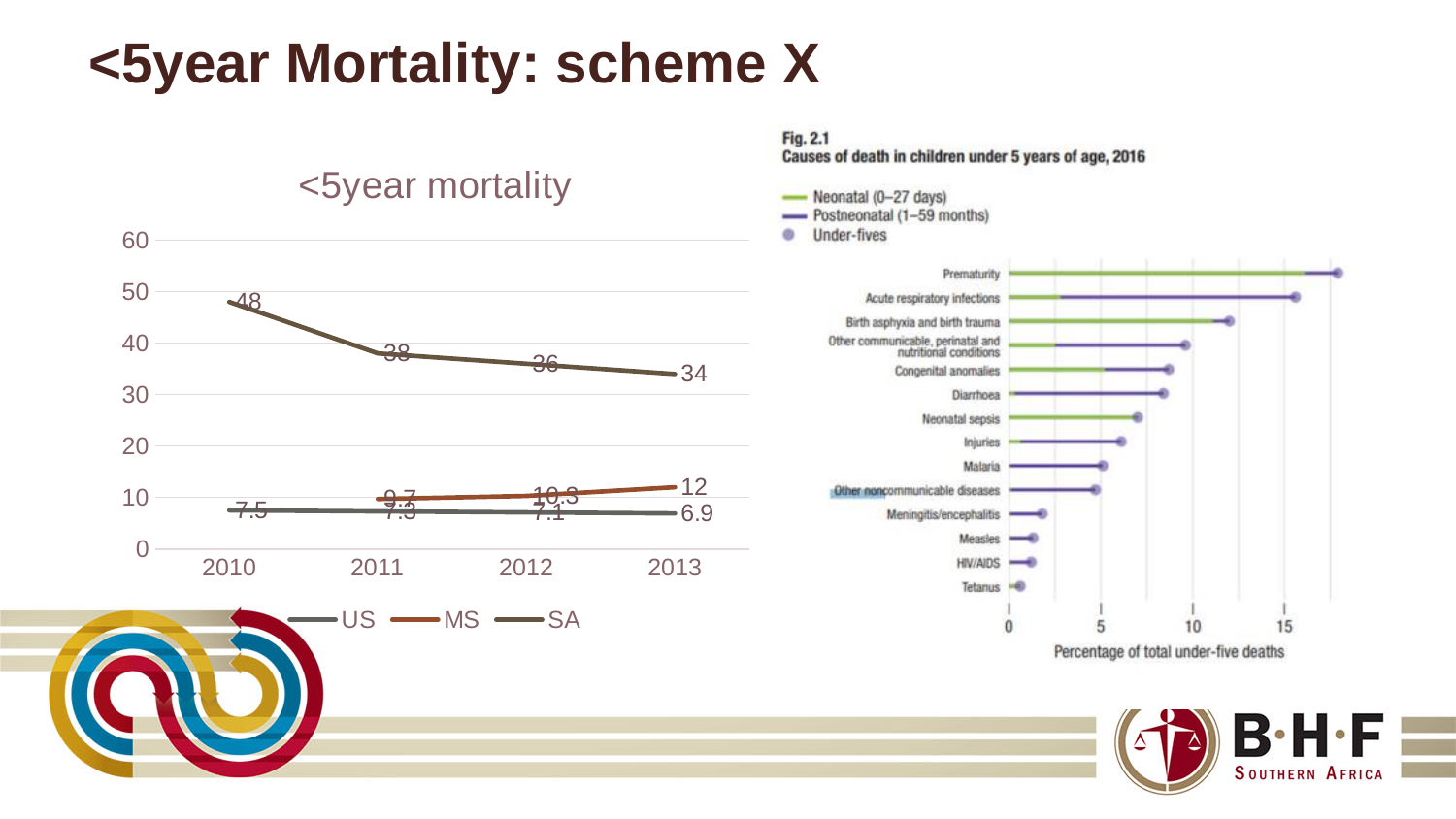
In the '<5year mortality' chart, what is the value for US in 2013? 6.9 In the '<5year mortality' chart, how many series does the legend list? 3 In the '<5year mortality' chart, what is the value for SA in 2013? 34 In the '<5year mortality' chart, which series has the highest values across all years? SA In the 'Fig. 2.1 Causes of death in children under 5 years of age, 2016' chart, is the value for Prematurity greater or less than 15? greater In the '<5year mortality' chart, what is the value for SA in 2010? 48 In the '<5year mortality' chart, what is the value for MS in 2013? 12 In the 'Fig. 2.1 Causes of death in children under 5 years of age, 2016' chart, which cause has the lowest percentage of total under-five deaths? Tetanus In the 'Fig. 2.1 Causes of death in children under 5 years of age, 2016' chart, which cause has the highest percentage of total under-five deaths? Prematurity In the '<5year mortality' chart, does the SA series rise or fall from 2010 to 2013? fall In the '<5year mortality' chart, which is larger in 2013, MS or US? MS In the '<5year mortality' chart, by how much did the SA value fall from 2010 to 2013? 14